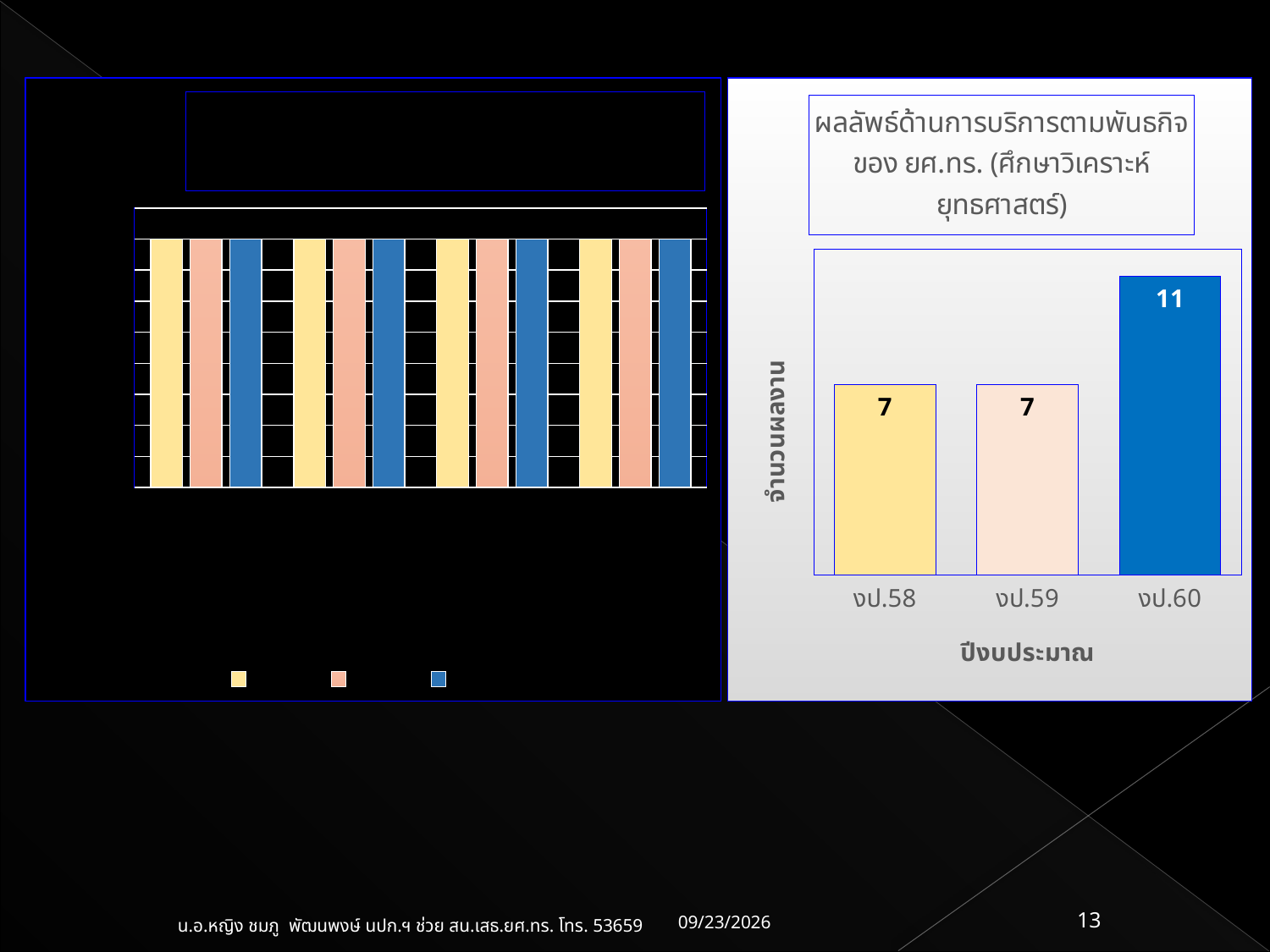
What kind of chart is the left-hand chart? Bar chart In the right-hand chart, which is larger, the value for งป.60 or the value for งป.59? งป.60 In the right-hand chart titled 'ผลลัพธ์ด้านการบริการตามพันธกิจ ของ ยศ.ทร. (ศึกษาวิเคราะห์ยุทธศาสตร์)', what is the value for งป.58? 7 What kind of chart is the right-hand chart? Bar chart In the right-hand chart, do the values rise or fall from งป.58 to งป.60? Rise In the right-hand chart, what is the value for งป.59? 7 What is the x-axis title of the right-hand chart? ปีงบประมาณ In the right-hand chart, which fiscal year has the highest value? งป.60 In the right-hand chart, what is the difference between the values for งป.60 and งป.58? 4 In the right-hand chart, what is the value for งป.60? 11 How many categories are shown on the x axis of the right-hand chart? 3 What is the y-axis title of the right-hand chart? จำนวนผลงาน